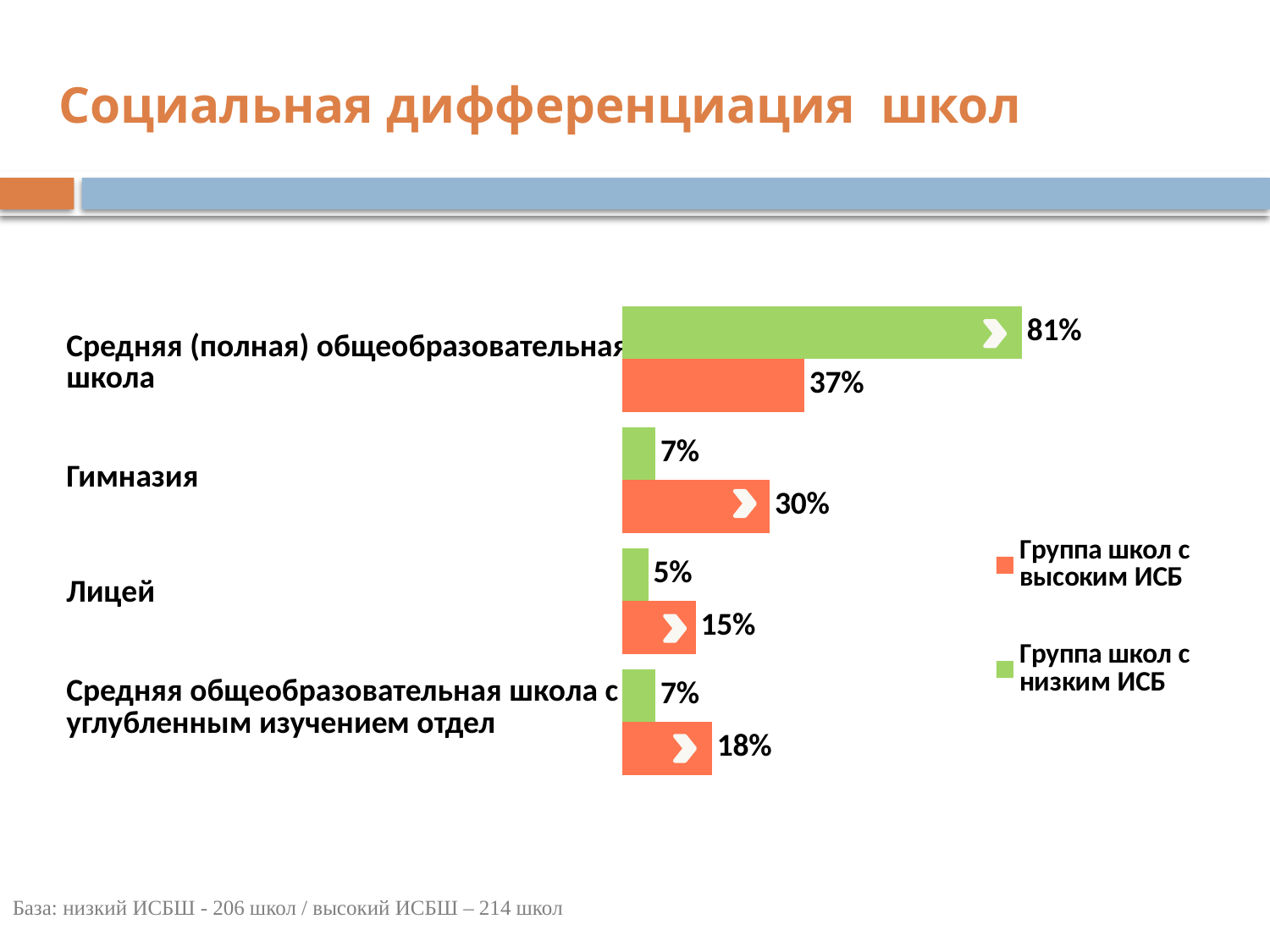
What is the value for Лицей in the series Группа школ с низким ИСБ? 5% Which category has the lowest value in the series Группа школ с низким ИСБ? Лицей How many school categories are shown in the chart? 4 What is the value for Гимназия in the series Группа школ с высоким ИСБ? 30% What is the value for Средняя общеобразовательная школа с углубленным изучением отдел in the series Группа школ с высоким ИСБ? 18% For Гимназия, which series has the larger value: Группа школ с высоким ИСБ or Группа школ с низким ИСБ? Группа школ с высоким ИСБ What is the value for Средняя (полная) общеобразовательная школа in the series Группа школ с низким ИСБ? 81% How many series does the legend list? 2 What kind of chart is shown on the slide? bar chart Which colour represents the series Группа школ с низким ИСБ in the chart? green What is the difference between the Группа школ с низким ИСБ and Группа школ с высоким ИСБ values for Средняя (полная) общеобразовательная школа? 44% Which category has the highest value in the series Группа школ с высоким ИСБ? Средняя (полная) общеобразовательная школа